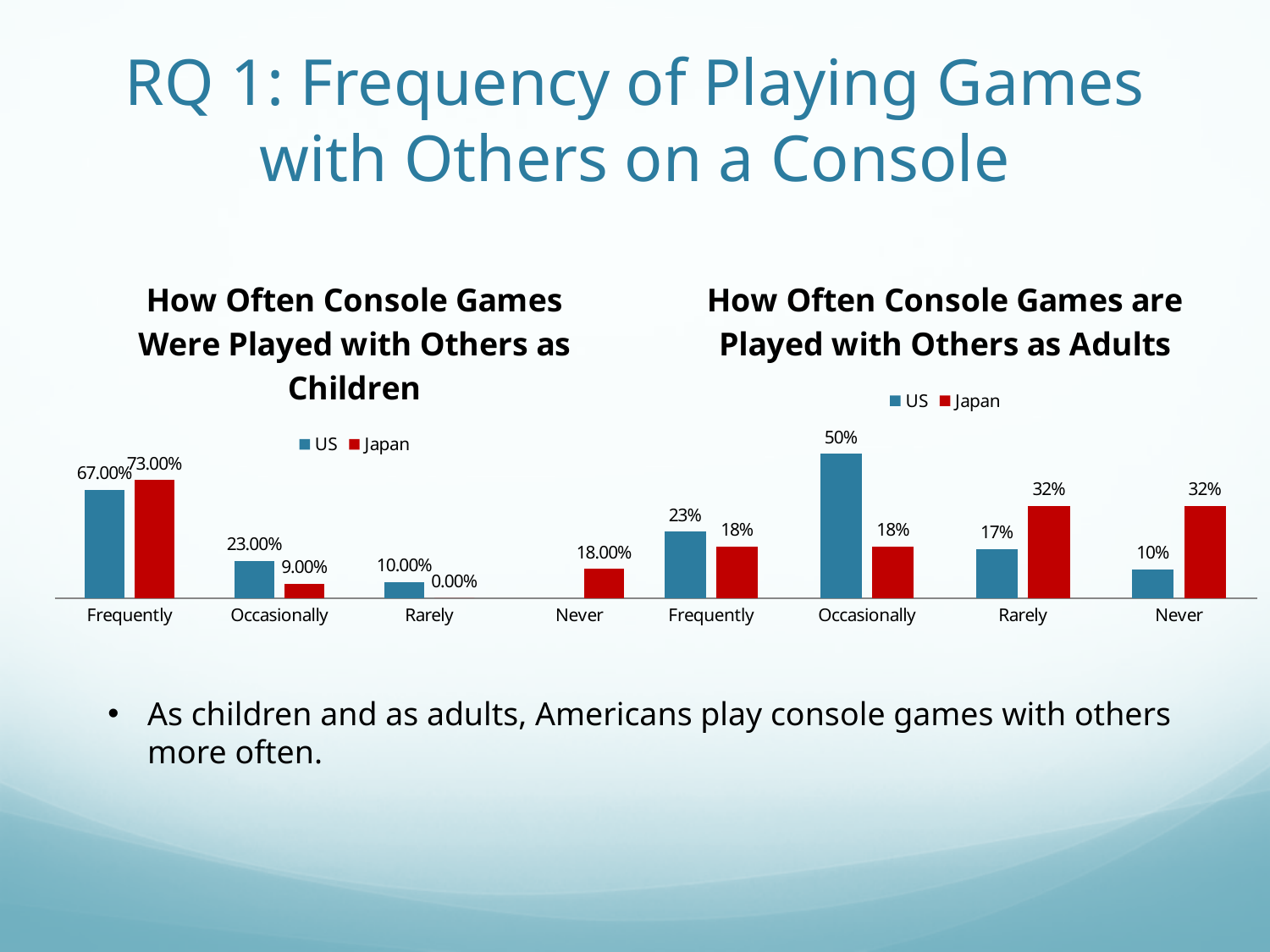
In the chart 'How Often Console Games are Played with Others as Adults', which category has the lowest US value? Never In the chart 'How Often Console Games are Played with Others as Adults', what is the difference between the US and Japan values for Occasionally? 32% In the chart 'How Often Console Games Were Played with Others as Children', which category has the highest US value? Frequently In the chart 'How Often Console Games Were Played with Others as Children', what is the difference between the Japan and US values for Frequently? 6.00% In the chart 'How Often Console Games Were Played with Others as Children', what is the Japan value for Occasionally? 9.00% In the chart 'How Often Console Games Were Played with Others as Children', what is the Japan value for Rarely? 0.00% How many series does the legend of the right-hand chart list? 2 What type of chart is the left-hand chart? Bar chart In the chart 'How Often Console Games Were Played with Others as Children', what is the US value for Frequently? 67.00% In the chart 'How Often Console Games are Played with Others as Adults', which is larger for Rarely, the US value or the Japan value? Japan In the chart 'How Often Console Games are Played with Others as Adults', what is the Japan value for Never? 32% In the chart 'How Often Console Games are Played with Others as Adults', what is the US value for Occasionally? 50%